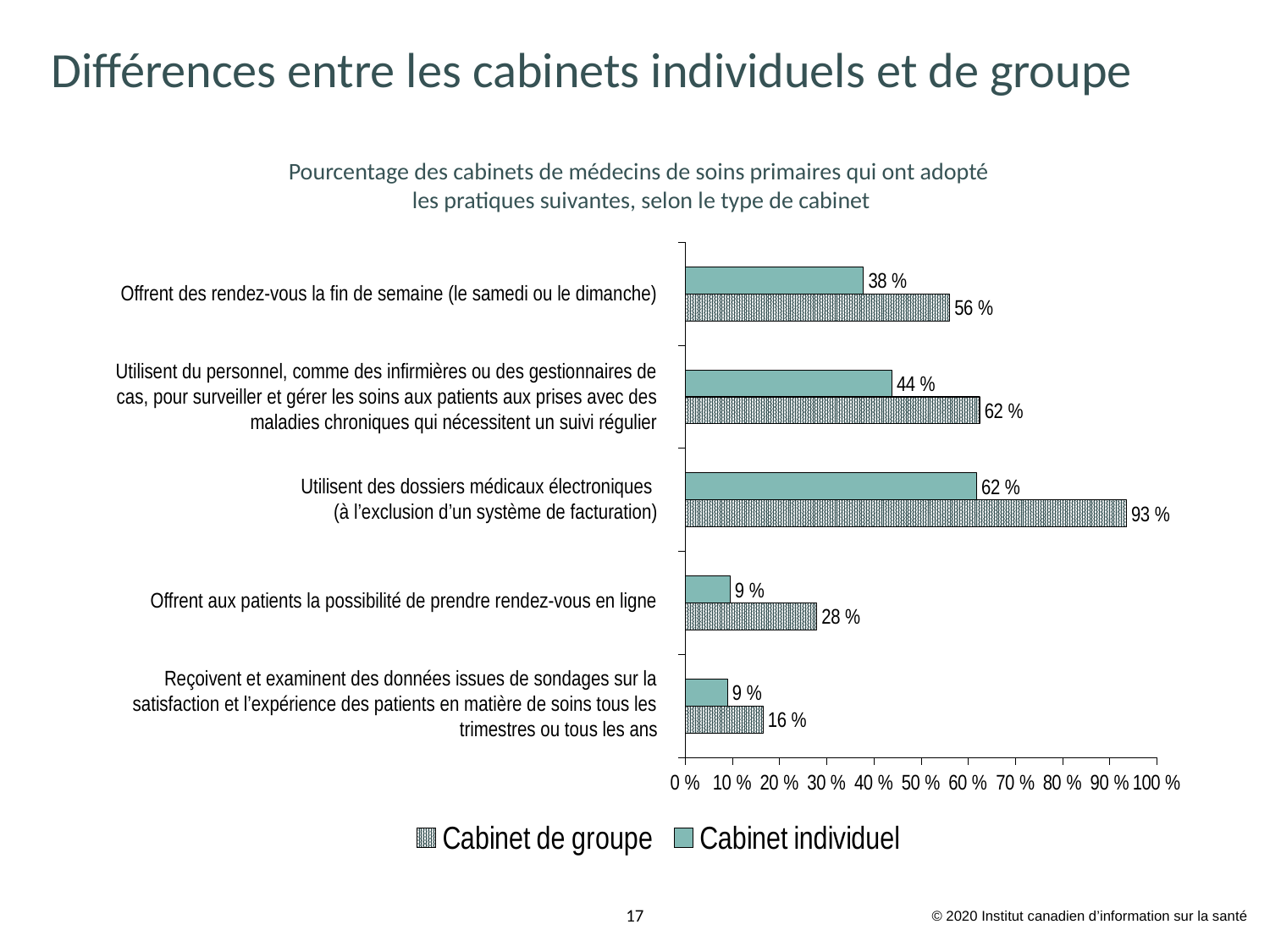
What is the difference between Cabinet de groupe and Cabinet individuel for 'Utilisent des dossiers médicaux électroniques'? 31 % Which practice has the lowest value for Cabinet de groupe? Reçoivent et examinent des données issues de sondages sur la satisfaction et l'expérience des patients Which practice has the highest value for Cabinet de groupe? Utilisent des dossiers médicaux électroniques (à l'exclusion d'un système de facturation) Is the value for Cabinet de groupe for 'Utilisent des dossiers médicaux électroniques' greater or less than 90 %? greater How many practices (categories) are shown on the chart? 5 What percentage of Cabinet de groupe use electronic medical records (Utilisent des dossiers médicaux électroniques)? 93 % For 'Utilisent du personnel, comme des infirmières ou des gestionnaires de cas', which is larger: Cabinet de groupe or Cabinet individuel? Cabinet de groupe What is the value for Cabinet de groupe for 'Offrent aux patients la possibilité de prendre rendez-vous en ligne'? 28 % What is the value for Cabinet individuel for 'Offrent des rendez-vous la fin de semaine'? 38 % What is the difference between Cabinet de groupe and Cabinet individuel for 'Offrent des rendez-vous la fin de semaine'? 18 % What type of chart is shown on the slide? Bar chart How many series does the legend list? 2